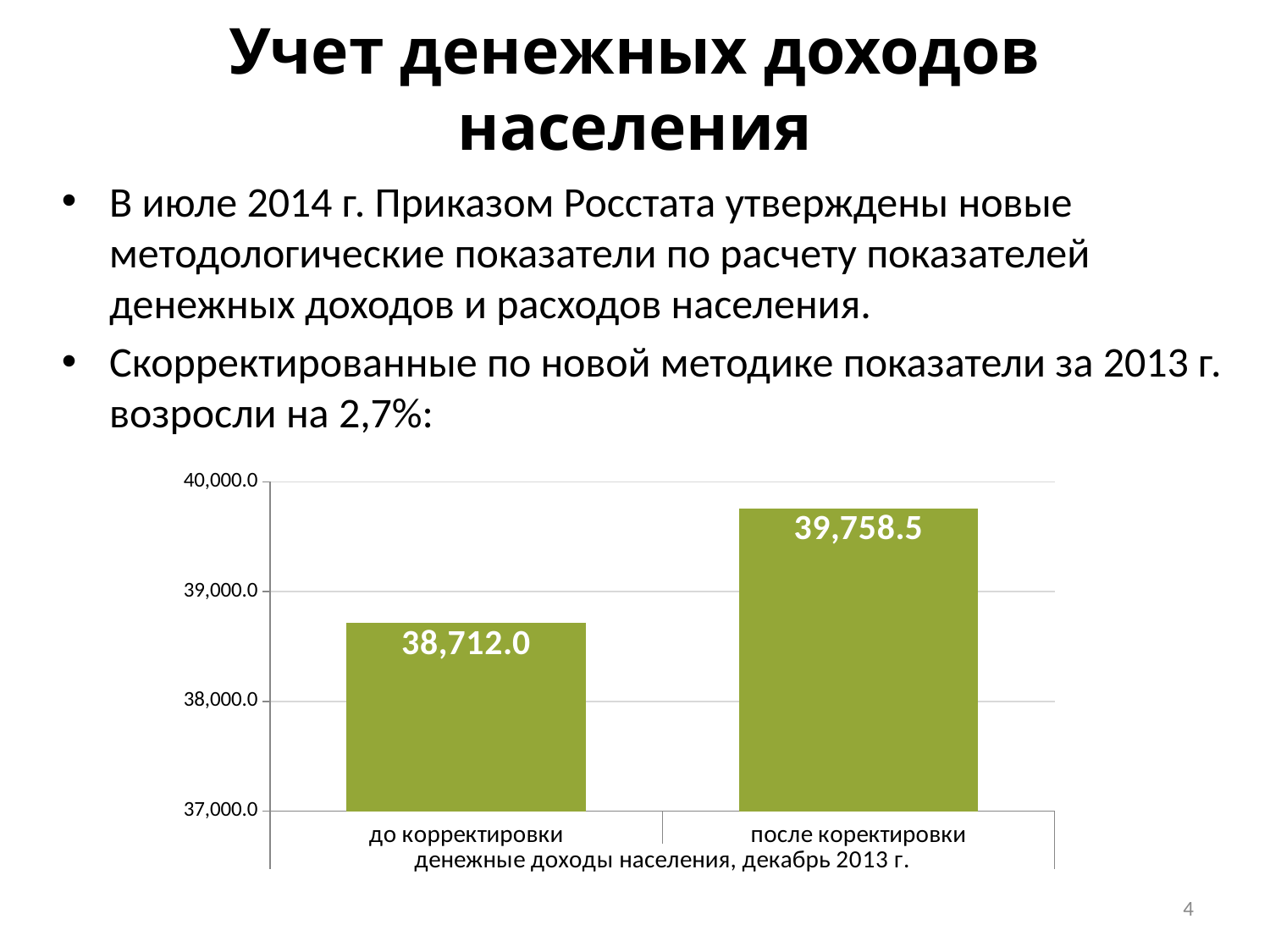
What is the difference between the values for "после коректировки" and "до корректировки"? 1,046.5 Which category has the higher value? после коректировки What kind of chart is shown on the slide? bar chart Is the value for "до корректировки" larger or smaller than the value for "после коректировки"? smaller What is the label shown under the category axis of the chart? денежные доходы населения, декабрь 2013 г. What is the value for "после коректировки"? 39,758.5 Which category has the lower value? до корректировки Is the value for "до корректировки" greater or less than 39,000.0? less What is the value for "до корректировки"? 38,712.0 Do the values rise or fall from left to right along the x axis? rise Is the value for "после коректировки" greater or less than 39,000.0? greater How many bars are shown in the chart? 2